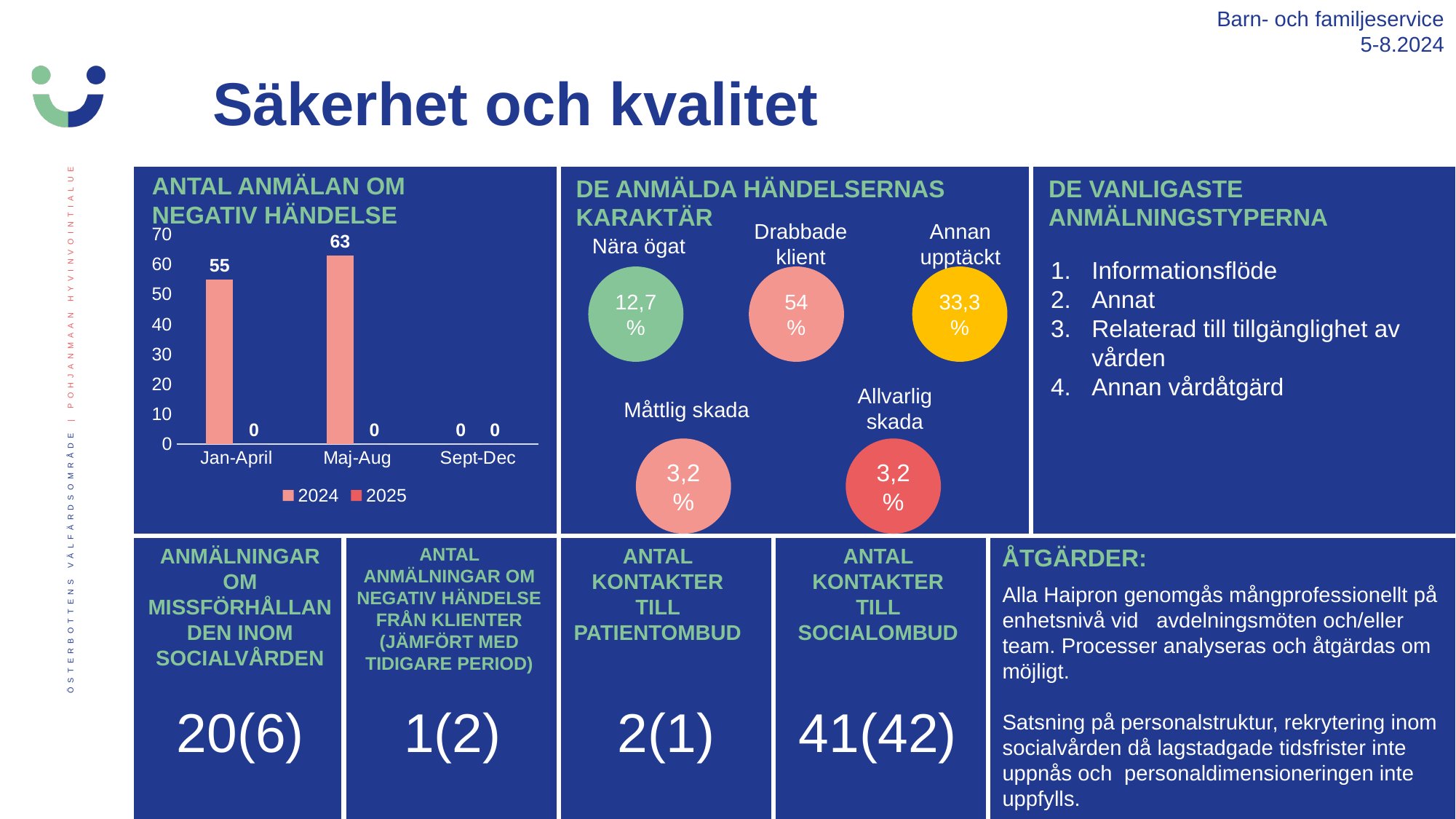
In the chart 'ANTAL ANMÄLAN OM NEGATIV HÄNDELSE', what is the value for 2024 in Jan-April? 55 What are the two series named in the legend of the chart 'ANTAL ANMÄLAN OM NEGATIV HÄNDELSE'? 2024 and 2025 How many periods are shown on the x axis of the chart 'ANTAL ANMÄLAN OM NEGATIV HÄNDELSE'? 3 In the chart 'ANTAL ANMÄLAN OM NEGATIV HÄNDELSE', is the 2024 value for Maj-Aug greater or less than 60? greater In the chart 'ANTAL ANMÄLAN OM NEGATIV HÄNDELSE', what is the value for 2024 in Maj-Aug? 63 In the chart 'ANTAL ANMÄLAN OM NEGATIV HÄNDELSE', which is larger for 2024: Jan-April or Maj-Aug? Maj-Aug How many series does the legend of the chart 'ANTAL ANMÄLAN OM NEGATIV HÄNDELSE' list? 2 What kind of chart is 'ANTAL ANMÄLAN OM NEGATIV HÄNDELSE'? bar chart In the chart 'ANTAL ANMÄLAN OM NEGATIV HÄNDELSE', which period has the lowest value for 2024? Sept-Dec In the chart 'ANTAL ANMÄLAN OM NEGATIV HÄNDELSE', what is the value for 2025 in Jan-April? 0 In the chart 'ANTAL ANMÄLAN OM NEGATIV HÄNDELSE', which period has the highest value for 2024? Maj-Aug In the chart 'ANTAL ANMÄLAN OM NEGATIV HÄNDELSE', what is the difference between the 2024 values for Maj-Aug and Jan-April? 8